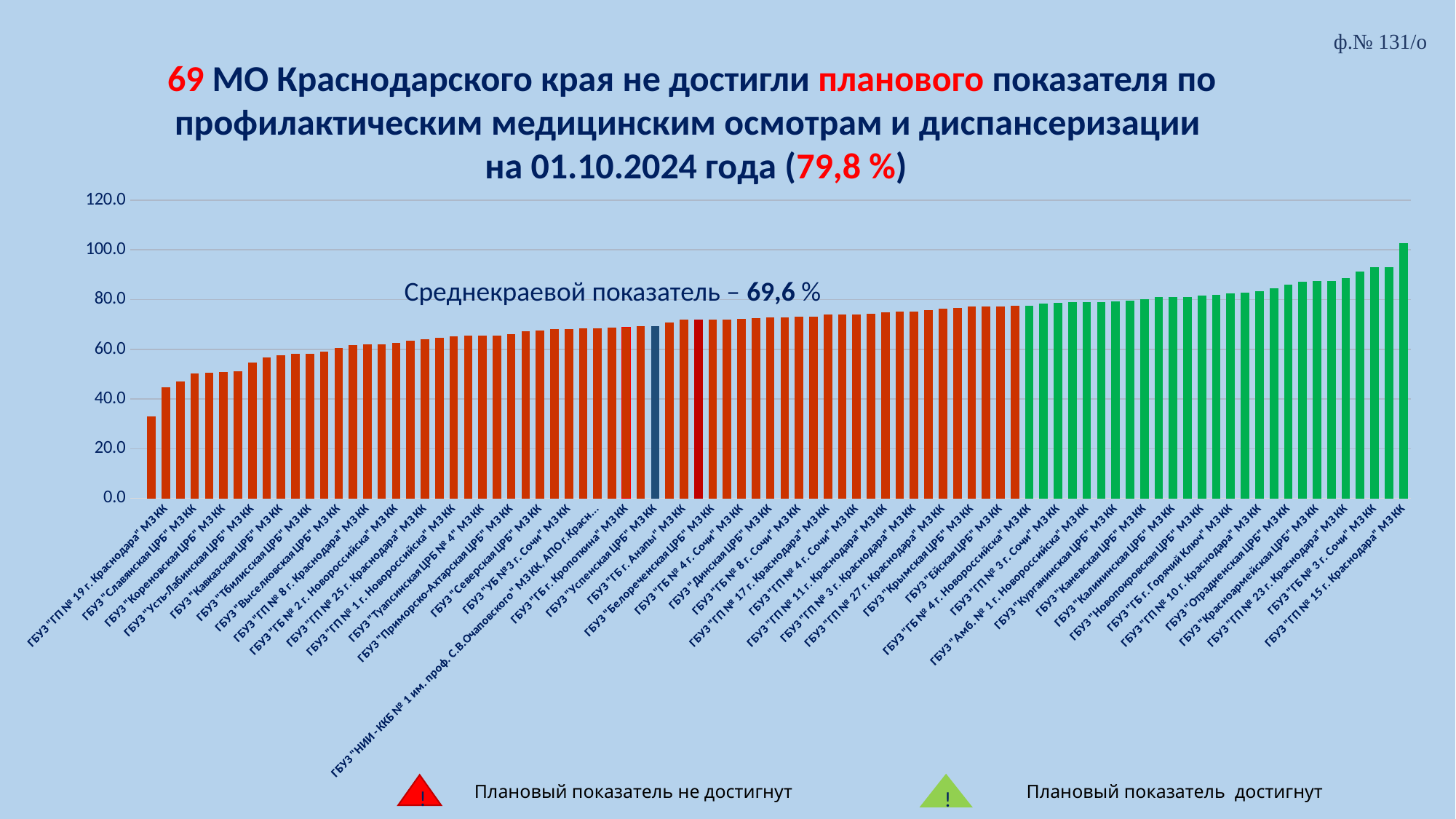
Is the value of the tallest bar greater or less than 100? greater What kind of chart is shown on the slide? bar chart Do the bar values rise or fall from left to right along the x axis? rise What is the planned indicator value given in the chart title? 79,8 % What is the highest tick value shown on the vertical axis? 120.0 Is the value of the dark blue bar greater or less than 80? less How many municipalities (МО) did not reach the planned indicator, according to the title? 69 What is the regional average value (Среднекраевой показатель) stated on the chart? 69,6 % Is the value of the shortest bar greater or less than 40? less According to the legend, what does the green triangle mean? Плановый показатель достигнут